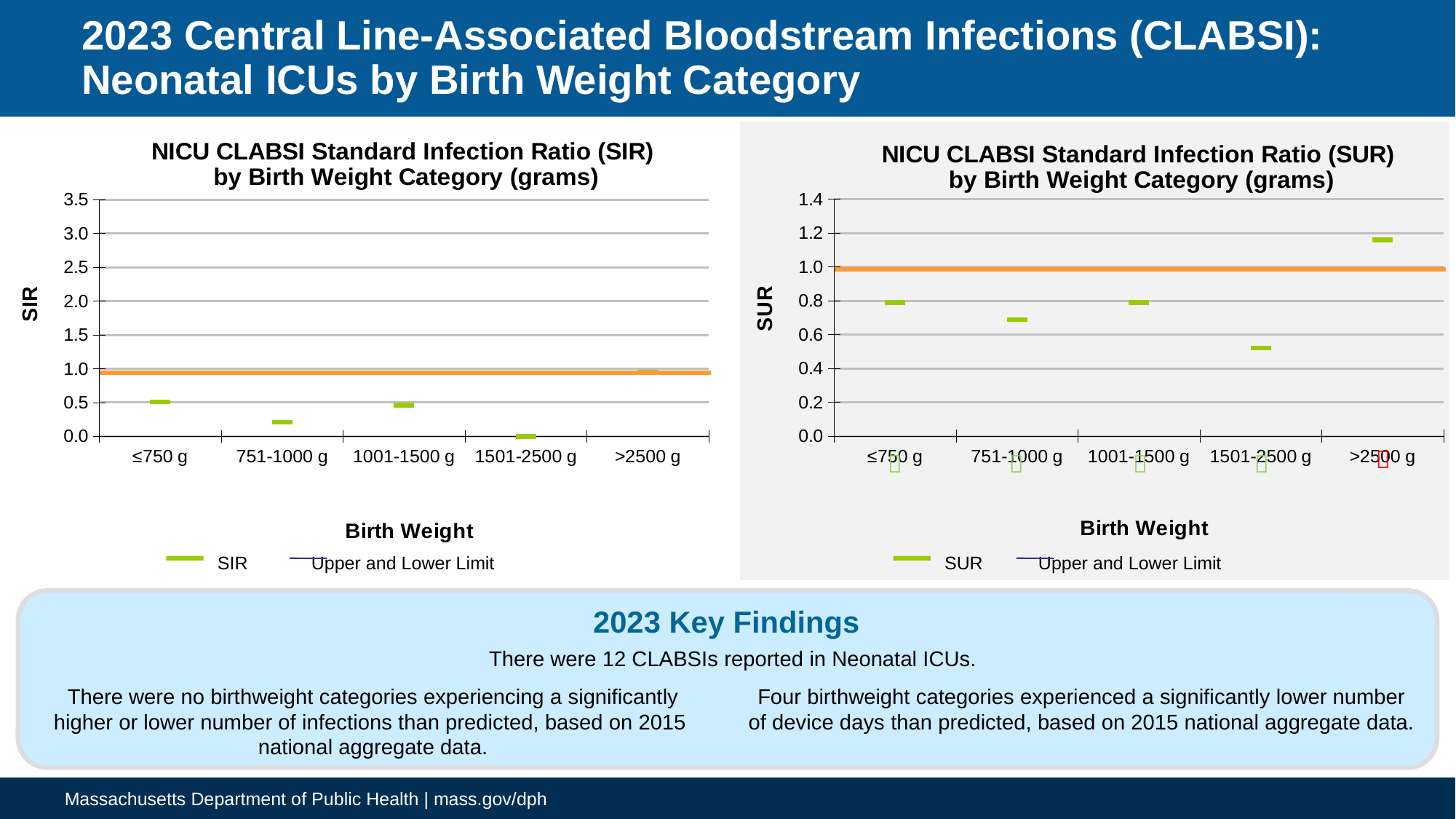
In the NICU CLABSI SIR chart on the left, which birth weight category has the highest SIR? >2500 g In the NICU CLABSI SUR chart on the right, is the SUR for 1501-2500 g greater or less than 0.6? less In the NICU CLABSI SUR chart on the right, is the SUR for >2500 g greater or less than 1.0? greater In the NICU CLABSI SIR chart on the left, which birth weight category has the lowest SIR? 1501-2500 g In the NICU CLABSI SUR chart on the right, what is the label on the y axis? SUR In the NICU CLABSI SUR chart on the right, which birth weight category has the lowest SUR? 1501-2500 g In the NICU CLABSI SIR chart on the left, which has the larger SIR: ≤750 g or 751-1000 g? ≤750 g In the NICU CLABSI SIR chart on the left, is the SIR for ≤750 g greater or less than 1.0? less In the NICU CLABSI SUR chart on the right, how many series does the legend list? 2 In the NICU CLABSI SUR chart on the right, which birth weight category has the highest SUR? >2500 g In the NICU CLABSI SIR chart on the left, how many birth weight categories are shown on the x axis? 5